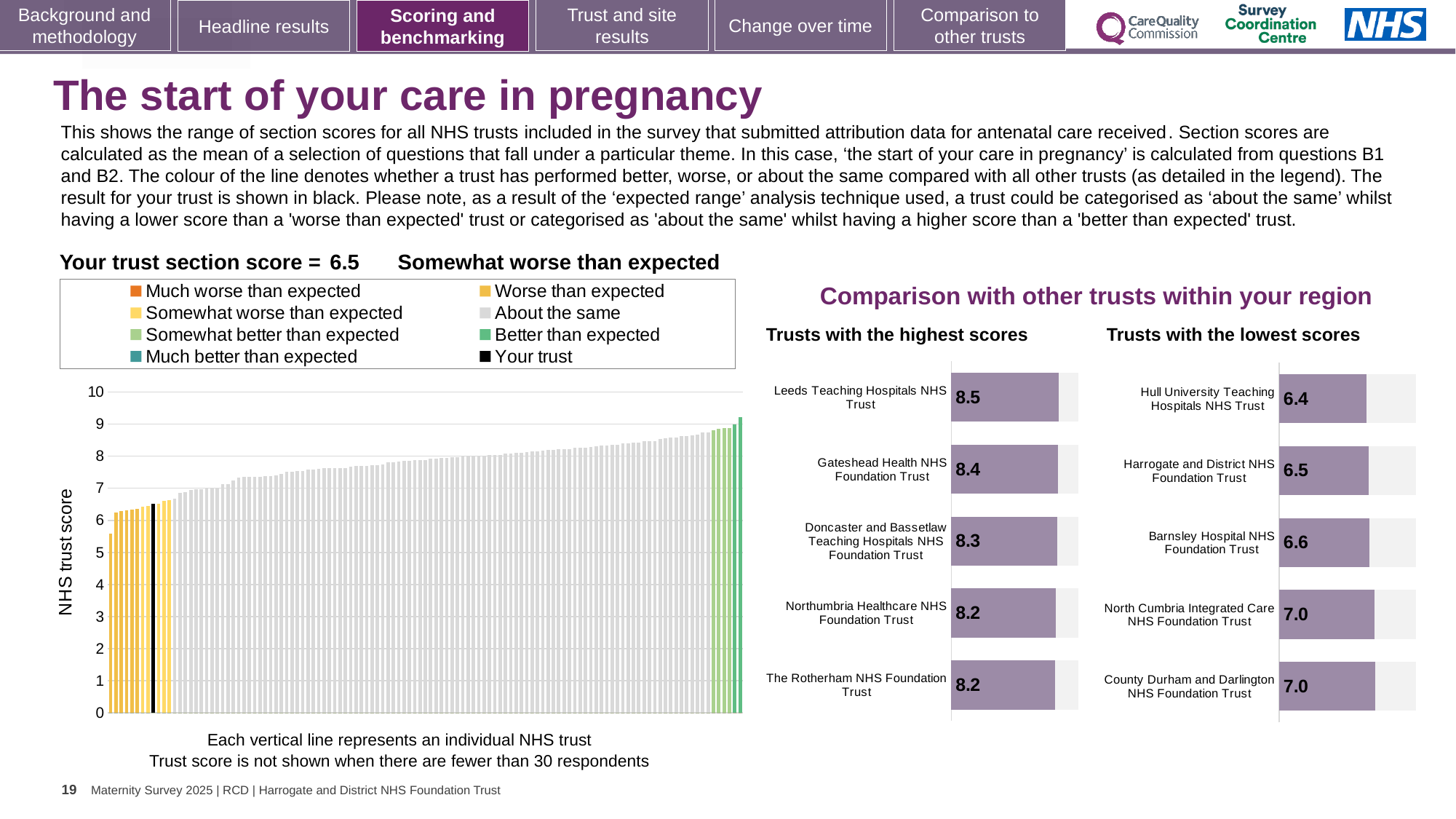
In the 'Trusts with the highest scores' chart, which trust has the highest score? Leeds Teaching Hospitals NHS Trust In the 'Trusts with the highest scores' chart, what is the difference between the scores of Leeds Teaching Hospitals NHS Trust and Gateshead Health NHS Foundation Trust? 0.1 In the 'Trusts with the lowest scores' chart, which trust has the lowest score? Hull University Teaching Hospitals NHS Trust What kind of chart is the main chart showing the NHS trust score for each trust? Bar chart In the 'Trusts with the highest scores' chart, what is the score for Doncaster and Bassetlaw Teaching Hospitals NHS Foundation Trust? 8.3 In the 'Trusts with the lowest scores' chart, what is the score for Hull University Teaching Hospitals NHS Trust? 6.4 In the 'Trusts with the highest scores' chart, what is the score for Leeds Teaching Hospitals NHS Trust? 8.5 How many trusts are shown in the 'Trusts with the highest scores' chart? 5 In the 'Trusts with the lowest scores' chart, what is the score for Barnsley Hospital NHS Foundation Trust? 6.6 How many entries does the legend of the main 'NHS trust score' chart list? 8 In the 'Trusts with the lowest scores' chart, which has the higher score: Harrogate and District NHS Foundation Trust or North Cumbria Integrated Care NHS Foundation Trust? North Cumbria Integrated Care NHS Foundation Trust In the 'Trusts with the lowest scores' chart, what is the difference between the scores of County Durham and Darlington NHS Foundation Trust and Hull University Teaching Hospitals NHS Trust? 0.6